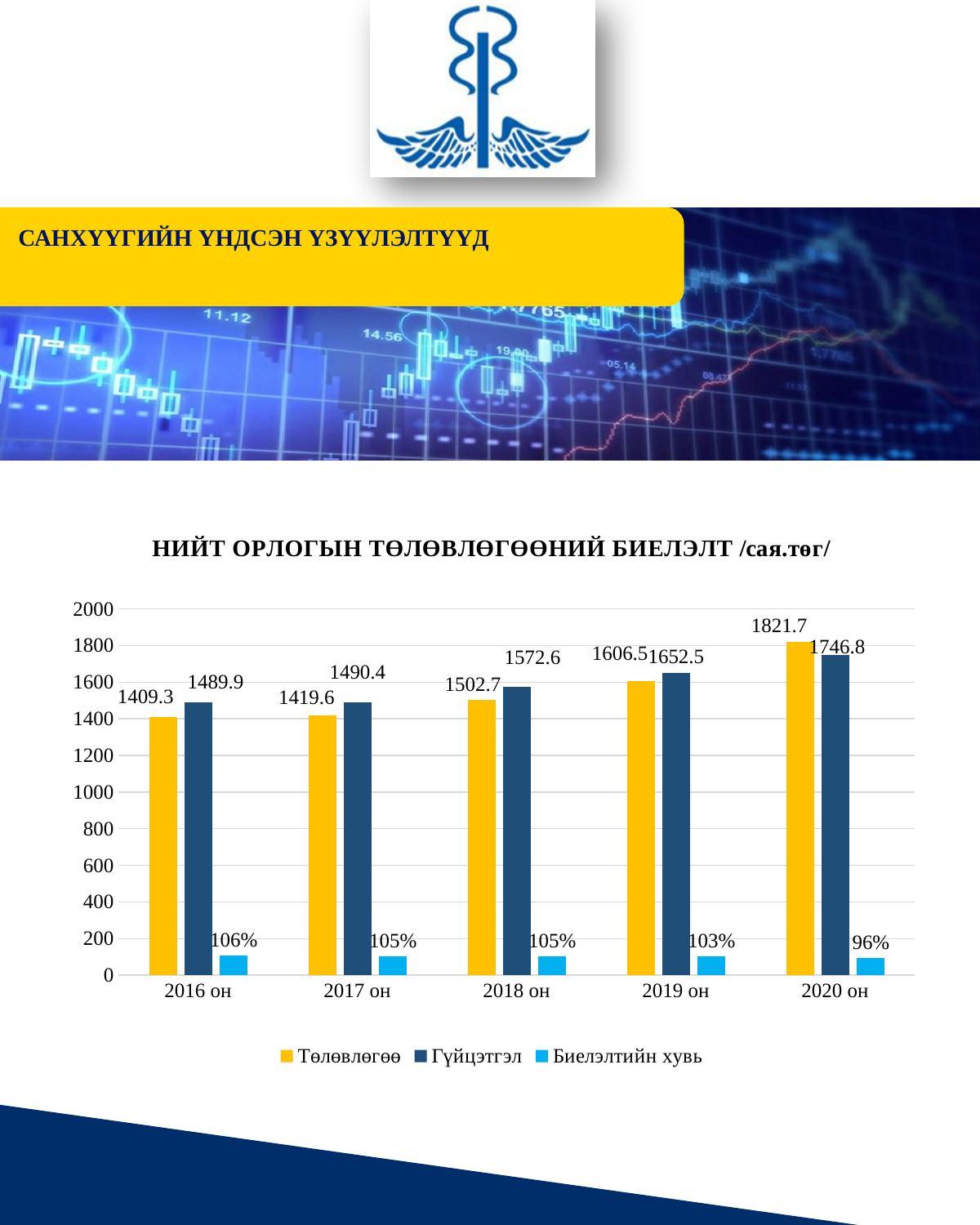
How many years are shown on the x axis? 5 What is the Биелэлтийн хувь value for 2020 он? 96% What is the Гүйцэтгэл value for 2018 он? 1572.6 What is the difference between the Төлөвлөгөө and Гүйцэтгэл values for 2020 он? 74.9 Which is larger for 2019 он, Төлөвлөгөө or Гүйцэтгэл? Гүйцэтгэл What kind of chart is shown? Bar chart How many series does the legend list? 3 Which year has the lowest Гүйцэтгэл value? 2016 он What is the Төлөвлөгөө value for 2016 он? 1409.3 What colour are the Гүйцэтгэл bars? Dark blue Which year has the highest Төлөвлөгөө value? 2020 он Does the Төлөвлөгөө value rise or fall from 2016 он to 2020 он? Rise